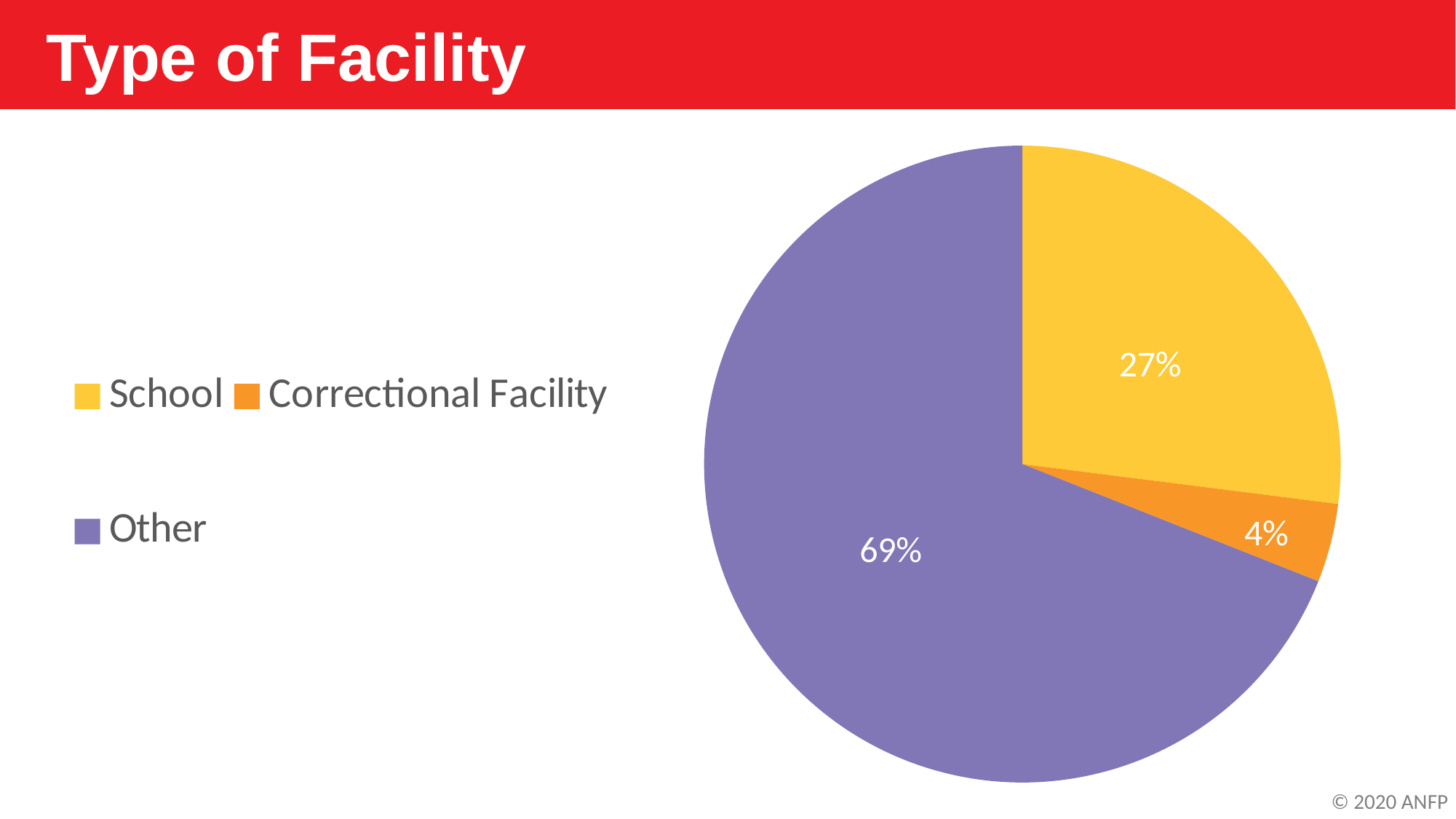
What share of the pie does Correctional Facility account for? 4% Which category has the largest slice of the pie? Other What kind of chart is shown on the slide? pie chart What share of the pie does School account for? 27% What share of the pie does Other account for? 69% Which is larger, the share for School or the share for Correctional Facility? School What is the title of the slide containing the chart? Type of Facility What is the difference in percentage points between School and Correctional Facility? 23 What is the difference in percentage points between Other and School? 42 What colour is the slice for Other? purple How many categories does the pie chart show? 3 Which category has the smallest slice of the pie? Correctional Facility